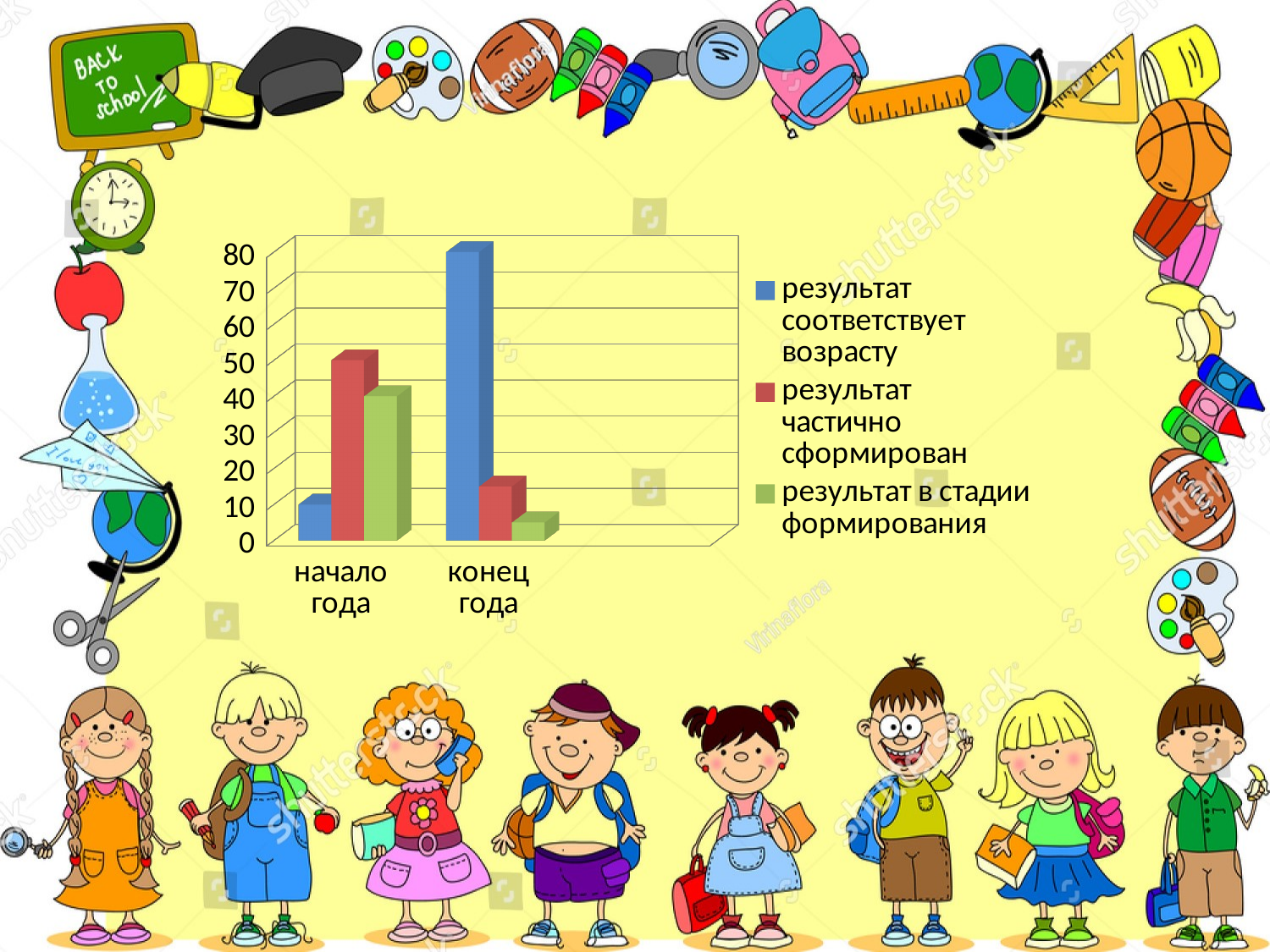
What colour represents the series "результат в стадии формирования" in the chart? green Which series is lowest for "конец года"? результат в стадии формирования Does the value for "результат соответствует возрасту" rise or fall from "начало года" to "конец года"? rise What kind of chart is shown on the slide? bar chart Is the value for "результат частично сформирован" at "конец года" greater or less than 30? less Is the value for "результат соответствует возрасту" at "начало года" greater or less than 20? less How many series does the chart legend list? 3 Which series is highest for "конец года"? результат соответствует возрасту Which is larger for "результат частично сформирован": the value at "начало года" or at "конец года"? начало года Is the value for "результат соответствует возрасту" at "конец года" greater or less than 70? greater How many categories are shown on the x axis of the chart? 2 Which series is highest for "начало года"? результат частично сформирован